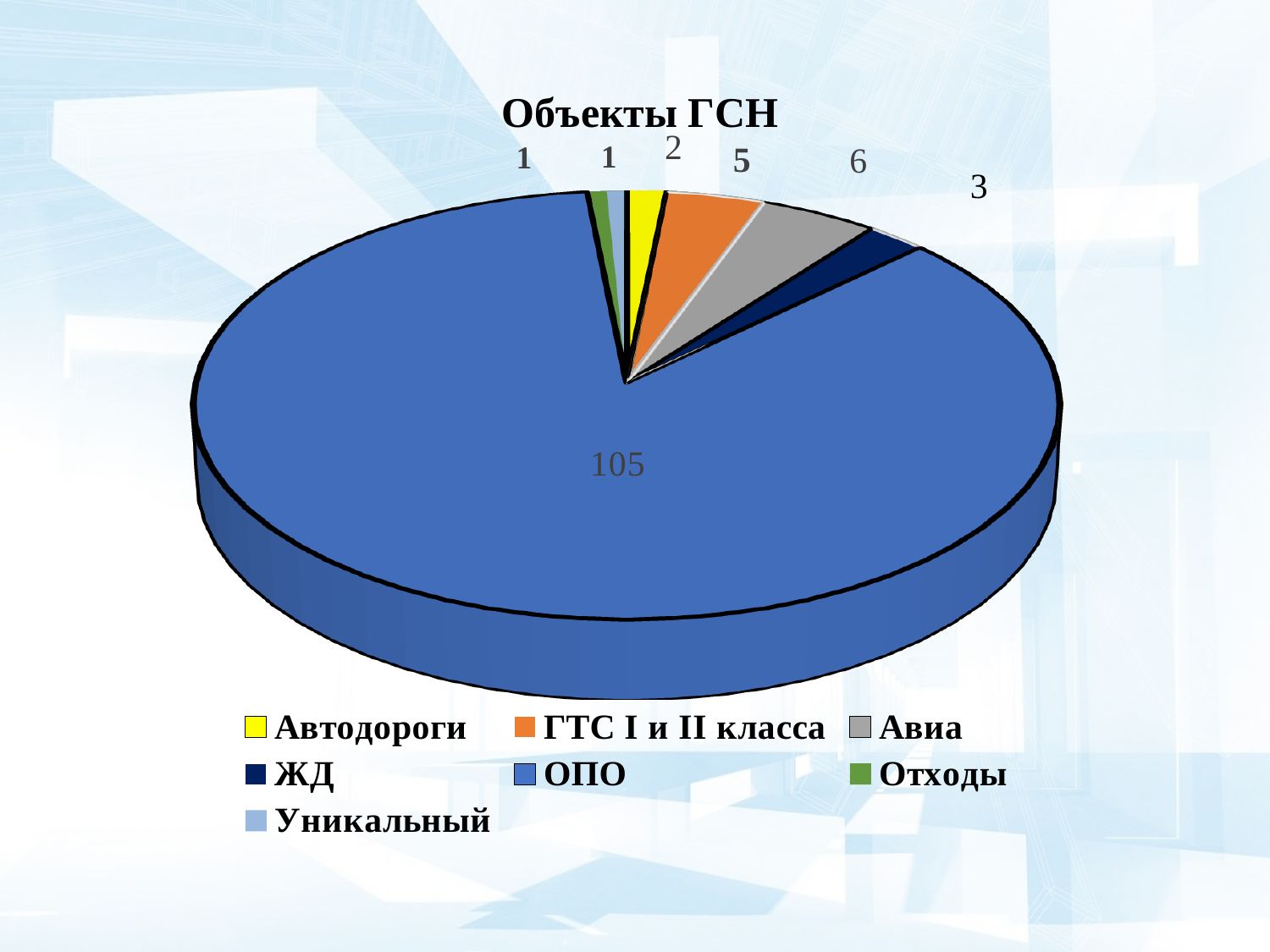
What is the value for Автодороги? 2 What is the value for ОПО? 105 What is the value for Отходы? 1 What type of chart is shown on the slide? pie chart Which category has the largest slice? ОПО How many categories does the legend list? 7 What is the title of the chart? Объекты ГСН What is the value for ЖД? 3 Which is larger, the value for Авиа or the value for ЖД? Авиа What is the difference between the values for ОПО and Авиа? 99 What is the value for Авиа? 6 What is the value for ГТС I и II класса? 5